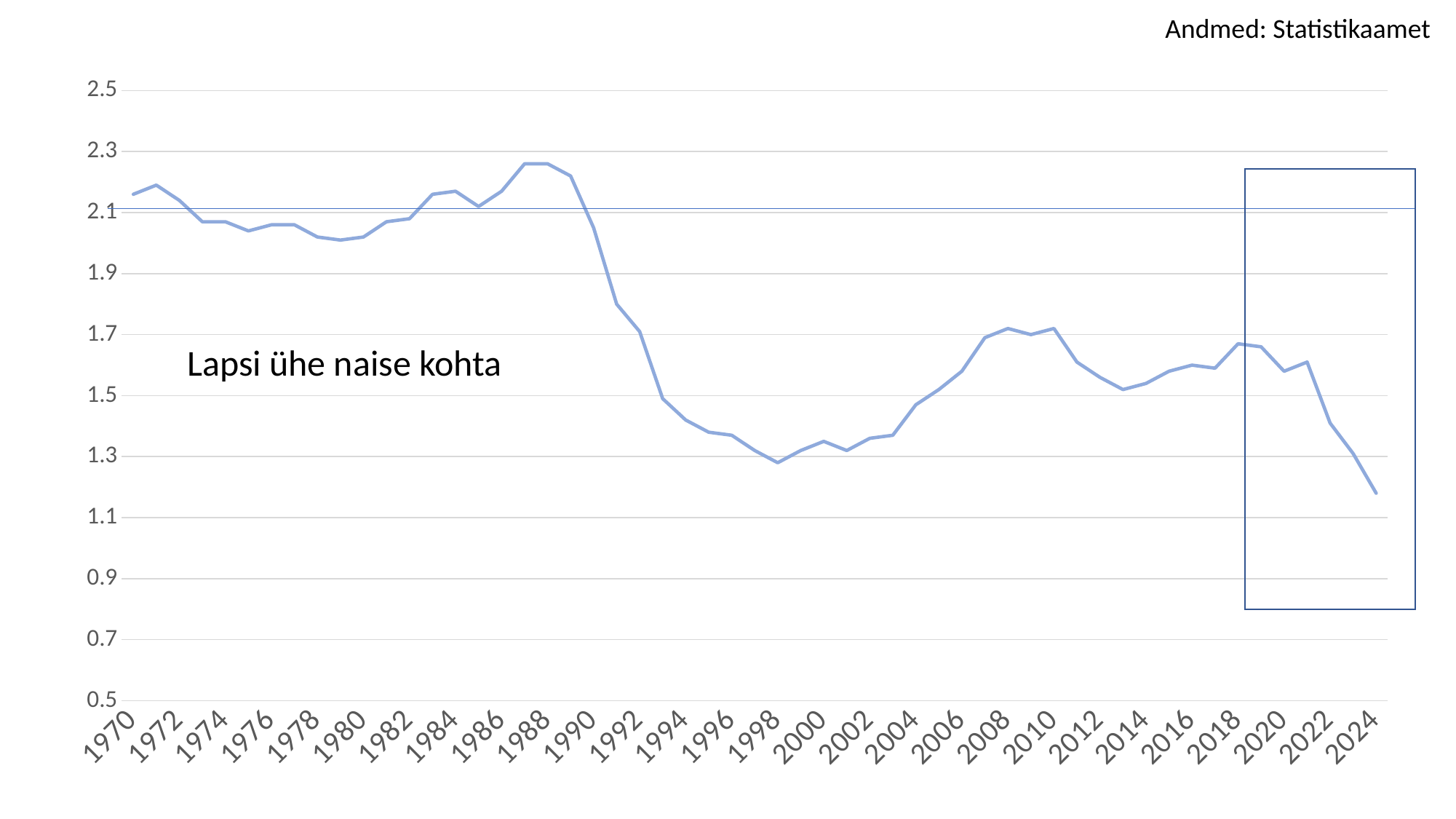
Is the value for 1998 greater or less than 1.5? less What kind of chart is shown on the slide? line chart Do the values rise or fall from 2018 to 2024? fall Do the values rise or fall from 1998 to 2008? rise What is the data source stated on the slide? Statistikaamet Which is larger, the value for 1998 or the value for 2024? 1998 Which year has the lowest value on the chart? 2024 Which year has the highest value on the chart? 1987 and 1988 (tied) Is the value for 1988 greater or less than 2.1? greater Is the value for 2008 greater or less than 1.5? greater Which is larger, the value for 1988 or the value for 2008? 1988